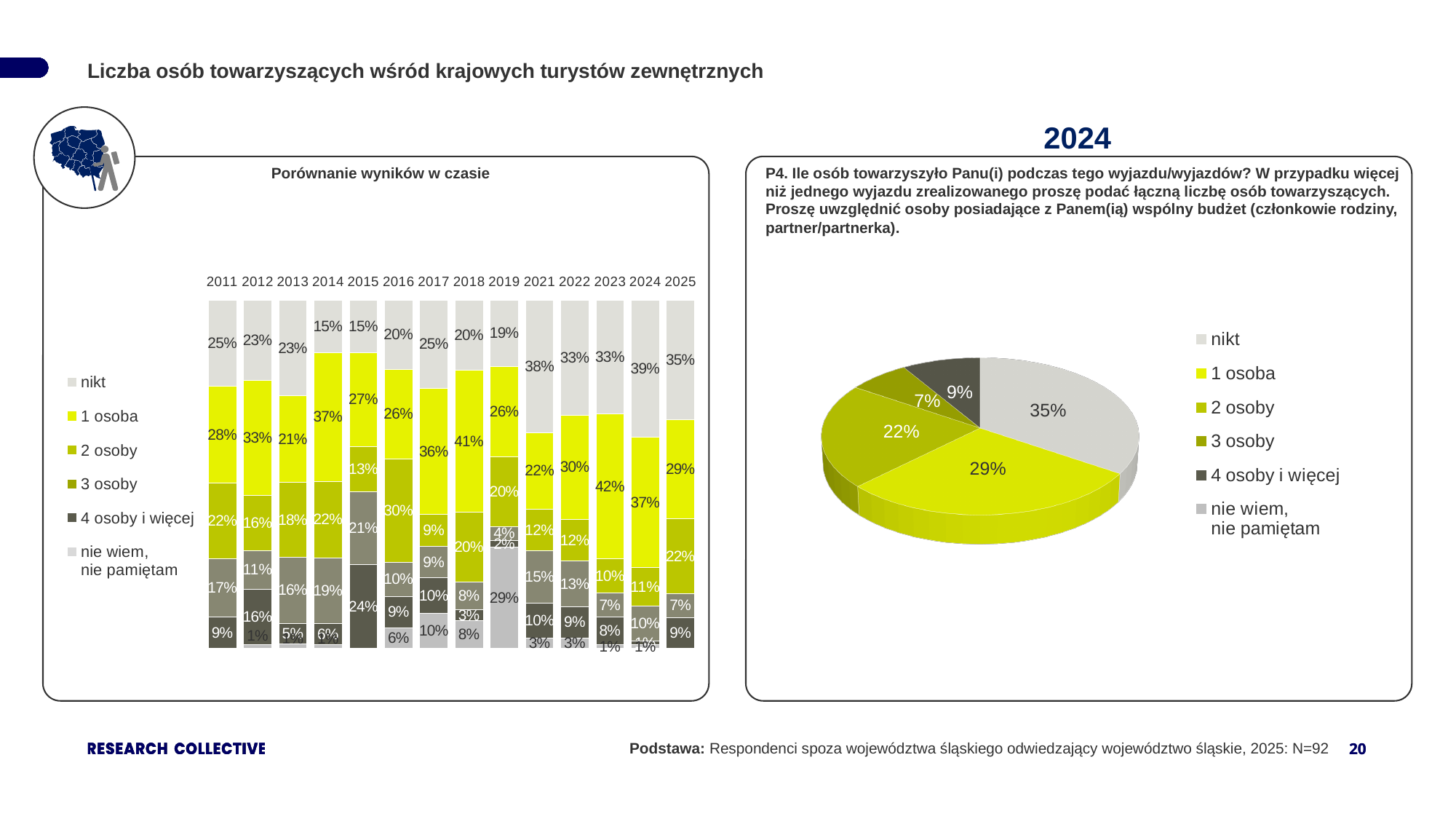
In the pie chart on the right, what share is shown for "3 osoby"? 7% In the pie chart on the right, which category has the largest slice? nikt In the chart "Porównanie wyników w czasie", what is the value for "nikt" in 2024? 39% In the chart "Porównanie wyników w czasie", what is the value for "1 osoba" in 2023? 42% In the chart "Porównanie wyników w czasie", what is the difference between the "nikt" value in 2021 and in 2011? 13 percentage points What kind of chart is the chart on the left titled "Porównanie wyników w czasie"? Stacked bar chart How many years are shown on the x axis of the chart "Porównanie wyników w czasie"? 14 In the pie chart on the right, what share is shown for "1 osoba"? 29% How many series does the legend of the chart "Porównanie wyników w czasie" list? 6 In the pie chart on the right, what share is shown for "nikt"? 35% In the chart "Porównanie wyników w czasie", which year has the larger value for "1 osoba": 2018 or 2019? 2018 What kind of chart is the chart on the right titled "2024"? Pie chart